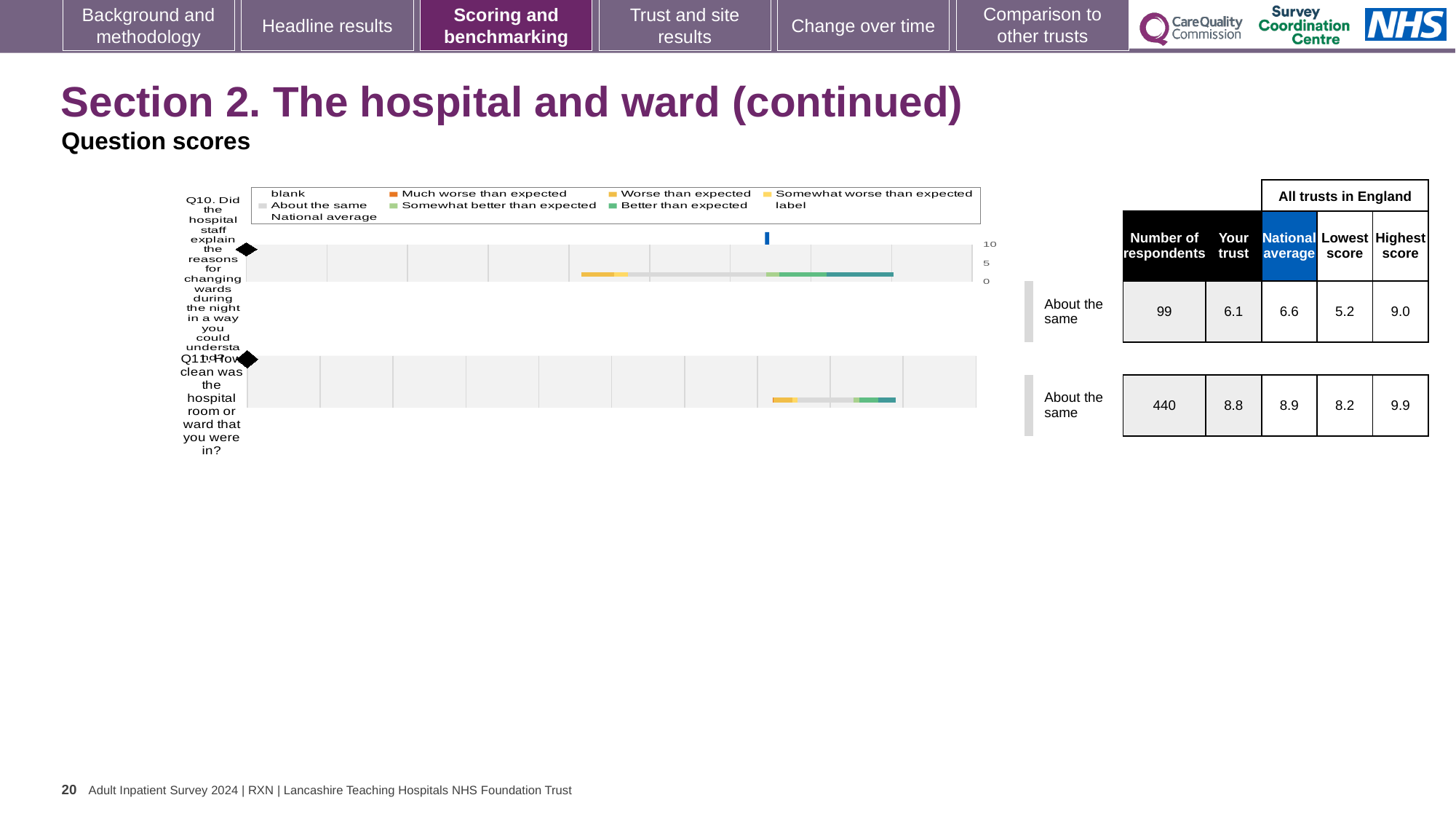
What is the 'Your trust' score for Q11 (How clean was the hospital room or ward that you were in?)? 8.8 What is the national average score for Q10 (Did the hospital staff explain the reasons for changing wards during the night)? 6.6 How many survey questions are plotted on the chart? 2 What is the maximum value shown on the chart's score axis? 10 What is the lowest score among all trusts in England for Q10? 5.2 How many respondents answered Q11? 440 Which question has the higher 'Your trust' score, Q10 or Q11? Q11 What benchmark category is the trust's Q10 score placed in? About the same What is the difference between the highest and lowest scores for Q11 across all trusts in England? 1.7 What kind of chart is used to show the question scores on this slide? bar chart By how much does the national average for Q10 exceed the trust's score for Q10? 0.5 Which legend entry is shown in dark orange? Much worse than expected